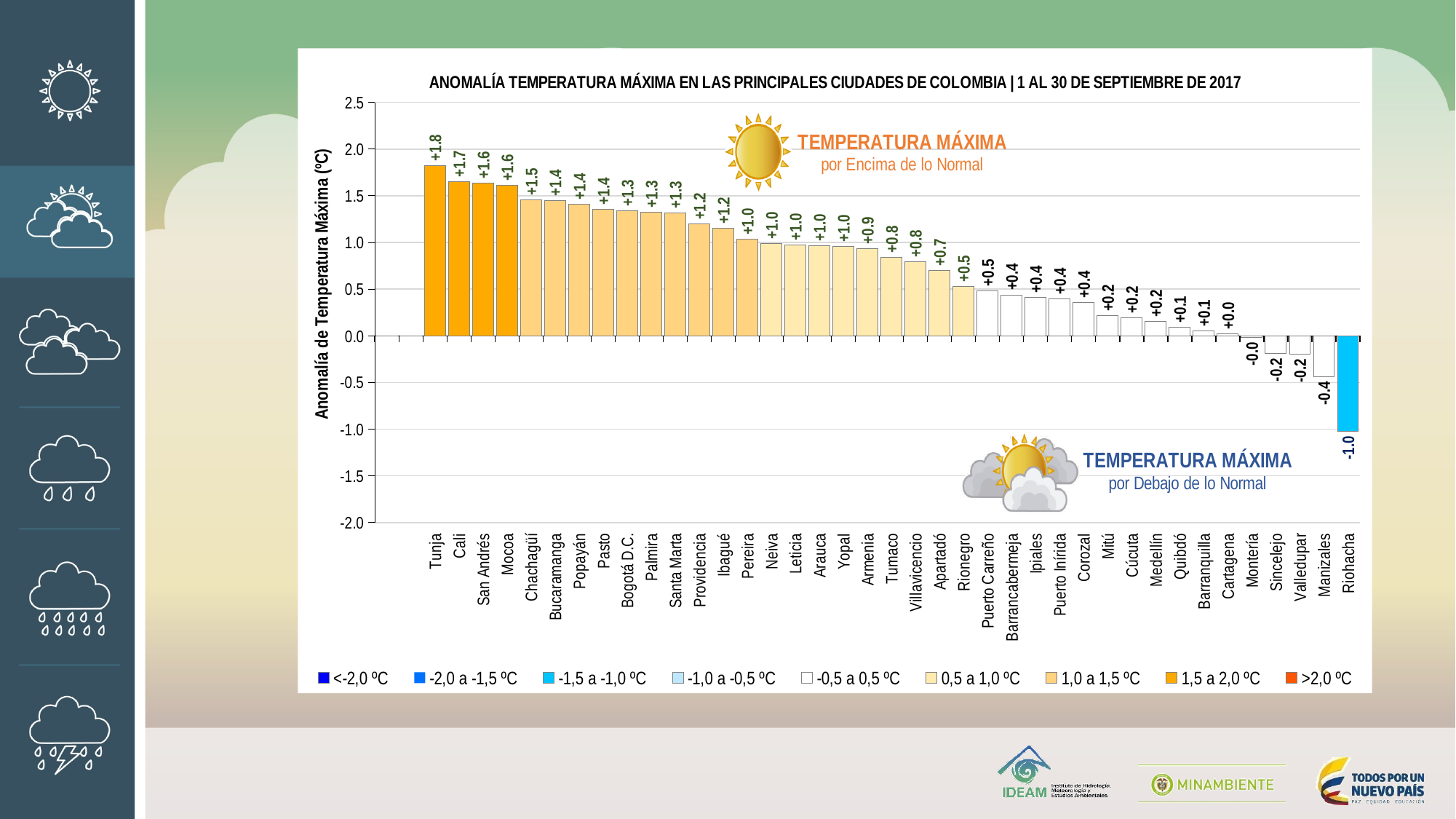
Which city has a larger anomaly value, Cali or Medellín? Cali How many temperature ranges does the legend list? 9 What kind of chart is shown on the slide? bar chart What is the anomaly value shown for Riohacha? -1.0 What is the anomaly value shown for Manizales? -0.4 What is the maximum temperature anomaly value shown for Tunja? +1.8 Which city has the highest maximum temperature anomaly? Tunja How many cities are plotted on the chart? 39 What is the difference between the anomaly values for Tunja and Riohacha? 2.8 Which city has the lowest maximum temperature anomaly? Riohacha Do the anomaly values rise or fall moving from left to right along the x axis? fall What is the anomaly value shown for Bogotá D.C.? +1.3